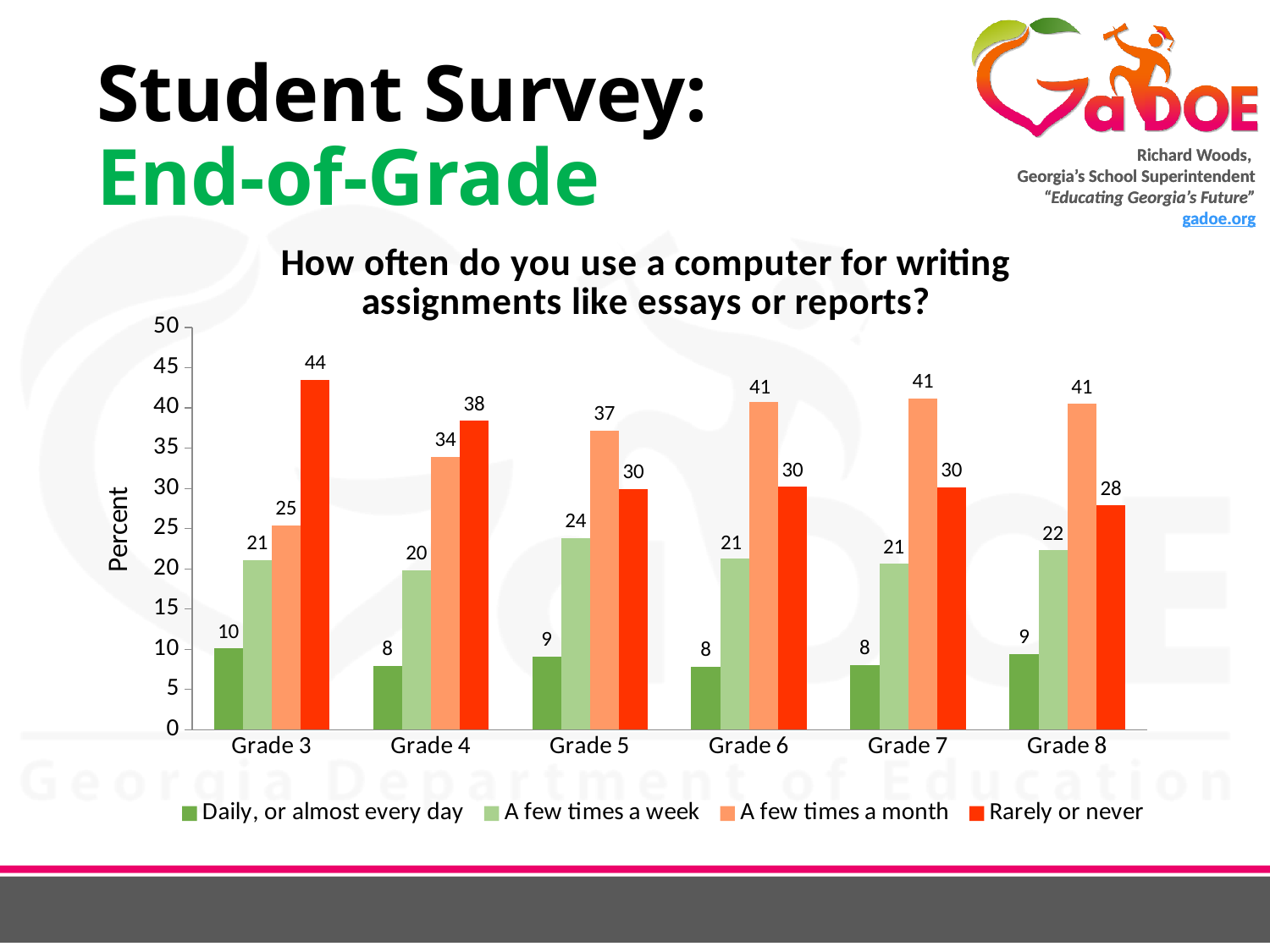
What is the value for "Rarely or never" in Grade 3? 44 What is the label on the vertical axis? Percent What kind of chart is shown on the slide? Bar chart Which grade has the lowest value for "A few times a month"? Grade 3 What is the difference between "Rarely or never" and "A few times a month" in Grade 4? 4 Which is larger in Grade 6: "A few times a month" or "Rarely or never"? A few times a month Which grade has the highest value for "Rarely or never"? Grade 3 What is the value for "A few times a month" in Grade 5? 37 What is the value for "Daily, or almost every day" in Grade 8? 9 Is the value for "A few times a week" in Grade 5 greater or less than 20? greater How many grade categories are shown on the x axis? 6 How many series does the legend list? 4